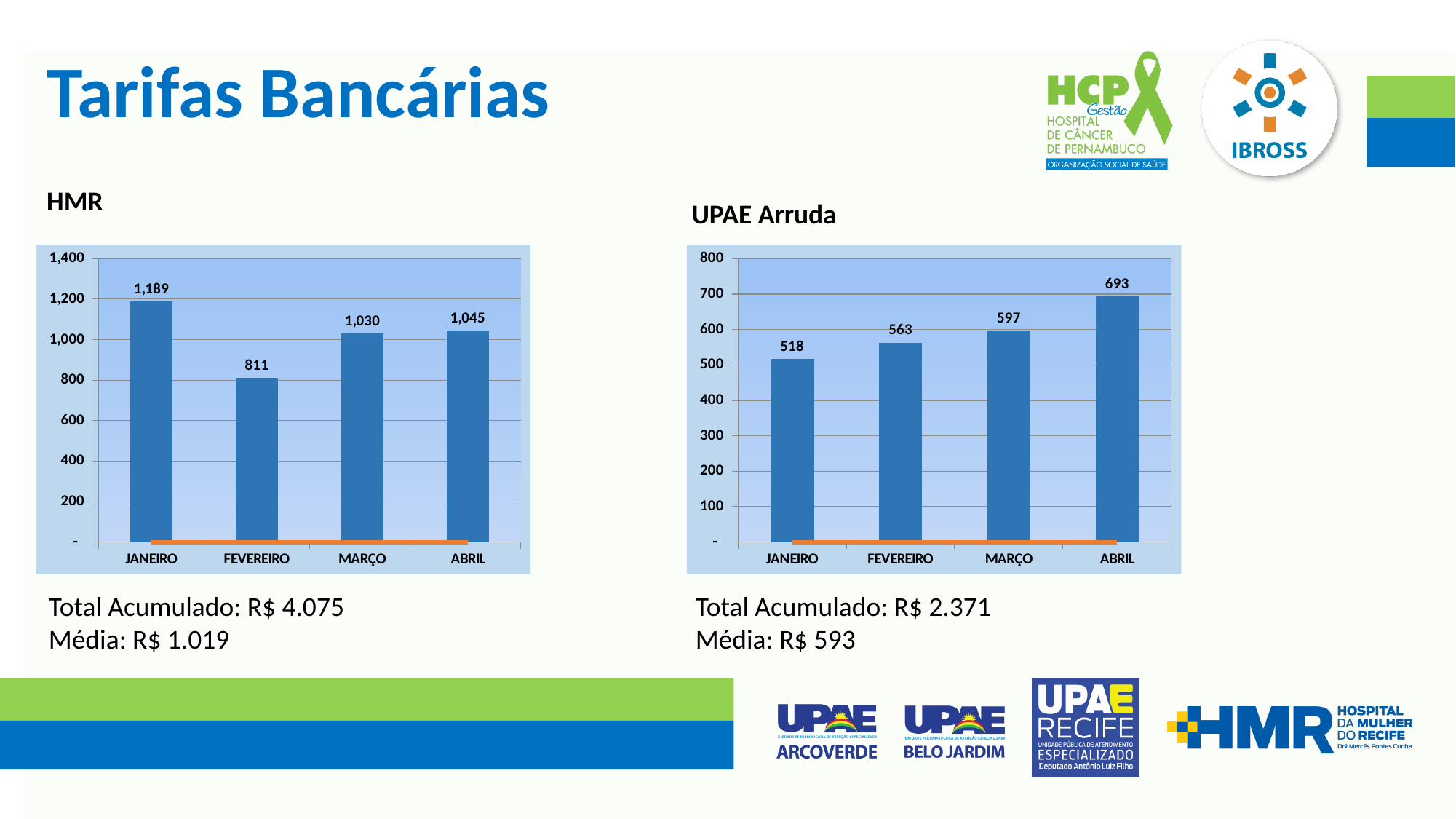
In the UPAE Arruda chart, what is the value for ABRIL? 693 In the UPAE Arruda chart, which month has the lowest value? JANEIRO How many months are shown in the UPAE Arruda chart? 4 In the UPAE Arruda chart, what is the value for MARÇO? 597 In the HMR chart, which month has the lowest value? FEVEREIRO In the HMR chart, what is the difference between the values for JANEIRO and FEVEREIRO? 378 In the HMR chart, which is larger, the value for MARÇO or the value for ABRIL? ABRIL In the HMR chart, which month has the highest value? JANEIRO In the HMR chart, what is the value for JANEIRO? 1,189 In the UPAE Arruda chart, what is the difference between the values for ABRIL and JANEIRO? 175 In the HMR chart, what is the value for FEVEREIRO? 811 In the UPAE Arruda chart, do the values rise or fall from JANEIRO to ABRIL? rise